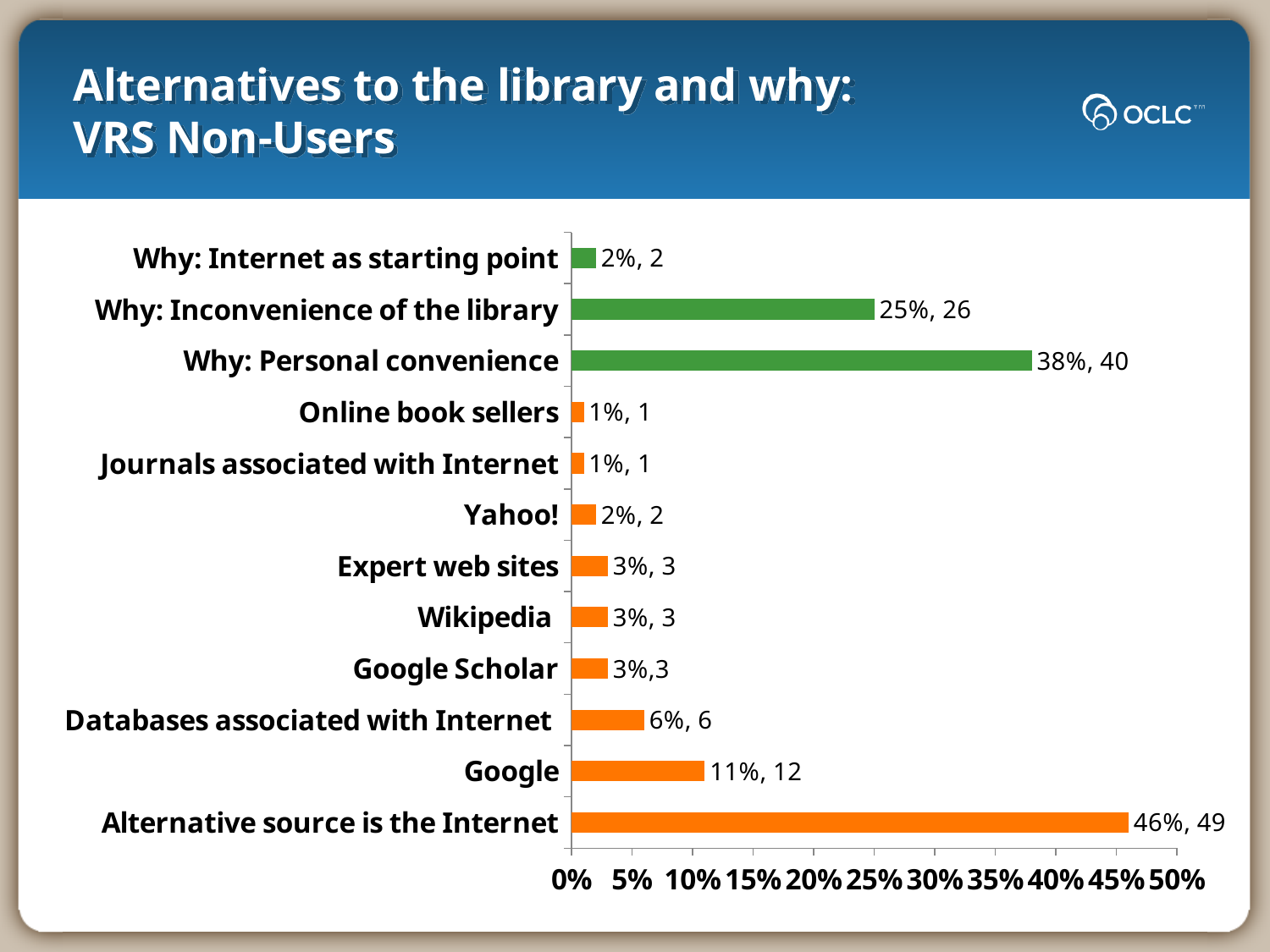
What percentage is shown for "Why: Personal convenience"? 38% What count is shown next to the percentage for "Why: Inconvenience of the library"? 26 What percentage is shown for "Alternative source is the Internet"? 46% What is the difference in percentage points between "Alternative source is the Internet" and "Why: Personal convenience"? 8% Which has the larger value, "Google" or "Databases associated with Internet"? Google Which category has the highest value in the chart? Alternative source is the Internet What colour are the bars for the three "Why:" categories? green Is the value for "Why: Inconvenience of the library" greater or less than 20%? greater What kind of chart is shown on the slide? bar chart How many categories are plotted in the chart? 12 What percentage is shown for "Google"? 11% What percentage is shown for "Databases associated with Internet"? 6%